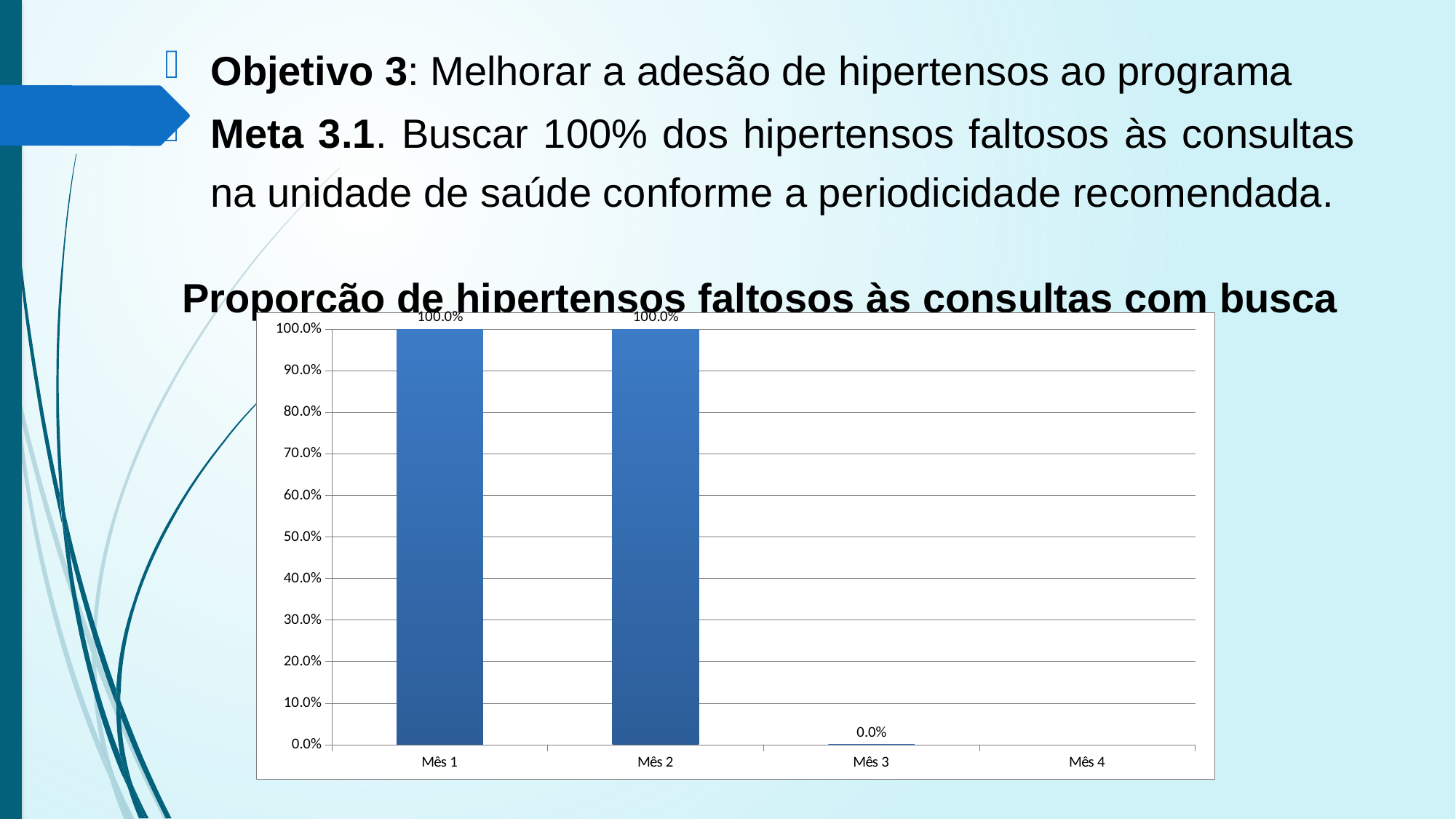
What is the value for Mês 1? 100.0% Do the values rise or fall from Mês 2 to Mês 3? fall What kind of chart is shown on the slide? bar chart What is the highest value shown on the vertical axis? 100.0% What colour are the bars in the chart? blue What is the difference between the value for Mês 2 and the value for Mês 3? 100.0% What is the value for Mês 2? 100.0% How many months (categories) are shown on the x axis? 4 Is the value for Mês 2 greater or less than 50.0%? greater Which is larger, the value for Mês 1 or the value for Mês 3? Mês 1 What is the value for Mês 3? 0.0%